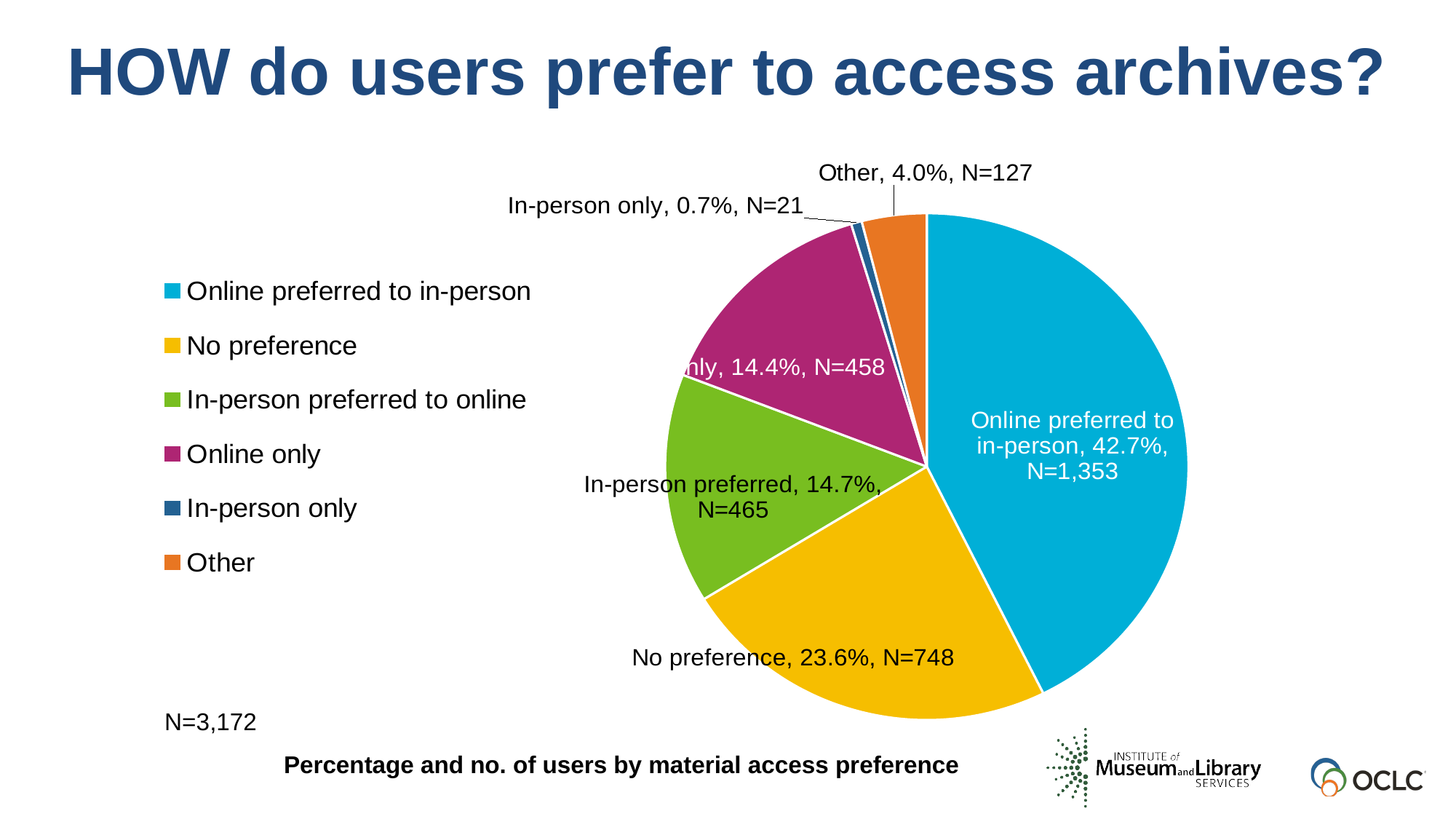
Which access preference has the smallest share of the pie? In-person only How many categories does the legend list? 6 What percentage of users prefer online to in-person? 42.7% How many users reported no preference? 748 What is the total N reported for the chart? N=3,172 How many users chose in-person only? 21 What percentage of users chose 'Other'? 4.0% What is the difference in number of users between 'In-person preferred' (N=465) and 'Online only' (N=458)? 7 Which is larger: the share for 'No preference' or the share for 'Other'? No preference Which access preference has the largest share of the pie? Online preferred to in-person What colour represents 'No preference' in the pie chart? yellow What kind of chart is shown on the slide? pie chart